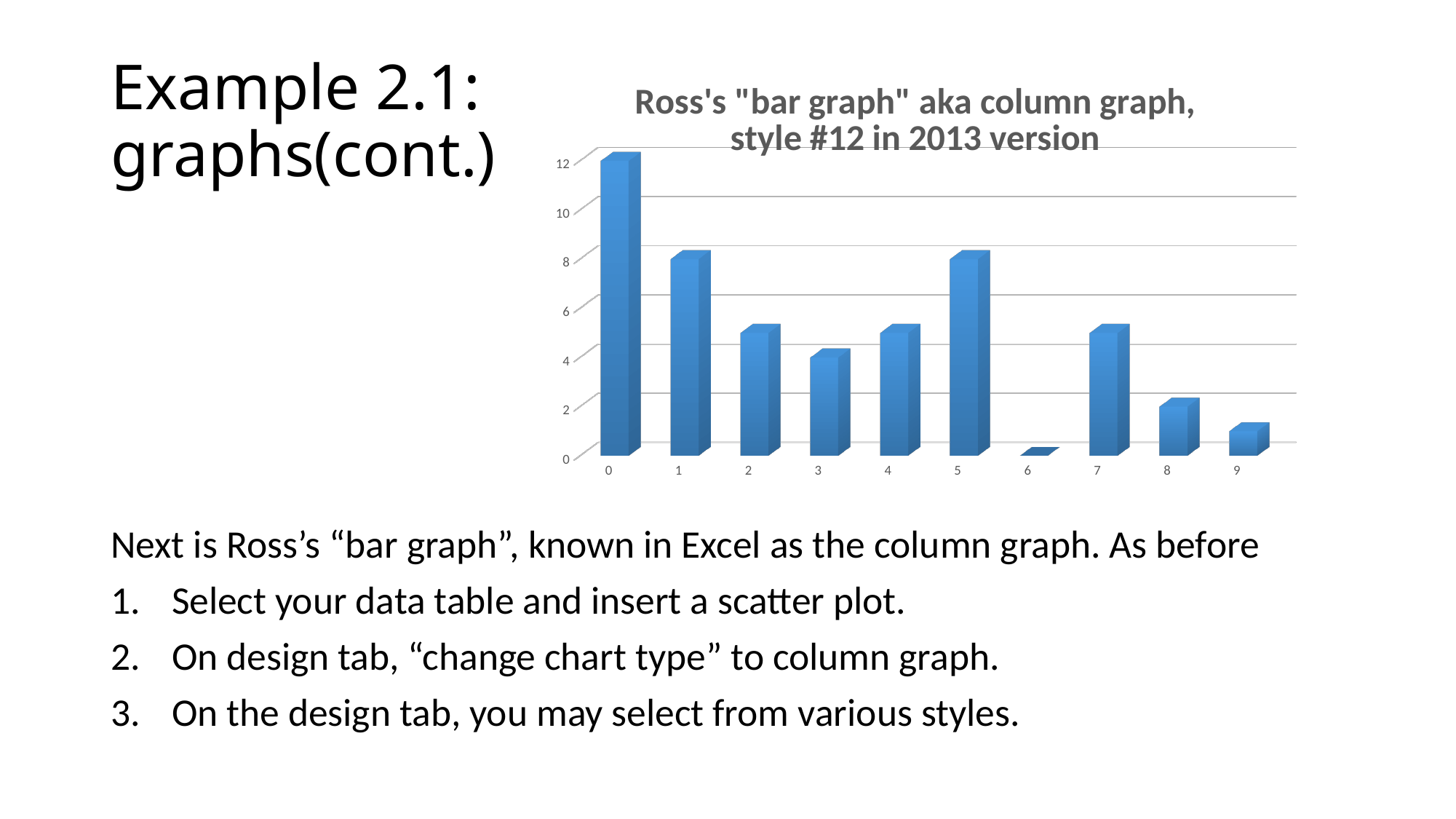
Which is larger, the value for category 0 or the value for category 5? 0 How many categories are plotted on the x axis? 10 What is the value for category 6? 0 What is the title of the chart? Ross's "bar graph" aka column graph, style #12 in 2013 version Is the value for category 9 greater or less than 2? less What is the value for category 1? 8 What is the value for category 8? 2 What is the value for category 0? 12 Is the value for category 2 greater or less than 4? greater Which category has the lowest bar? 6 What kind of chart is shown on the slide? bar chart Which category has the highest bar? 0